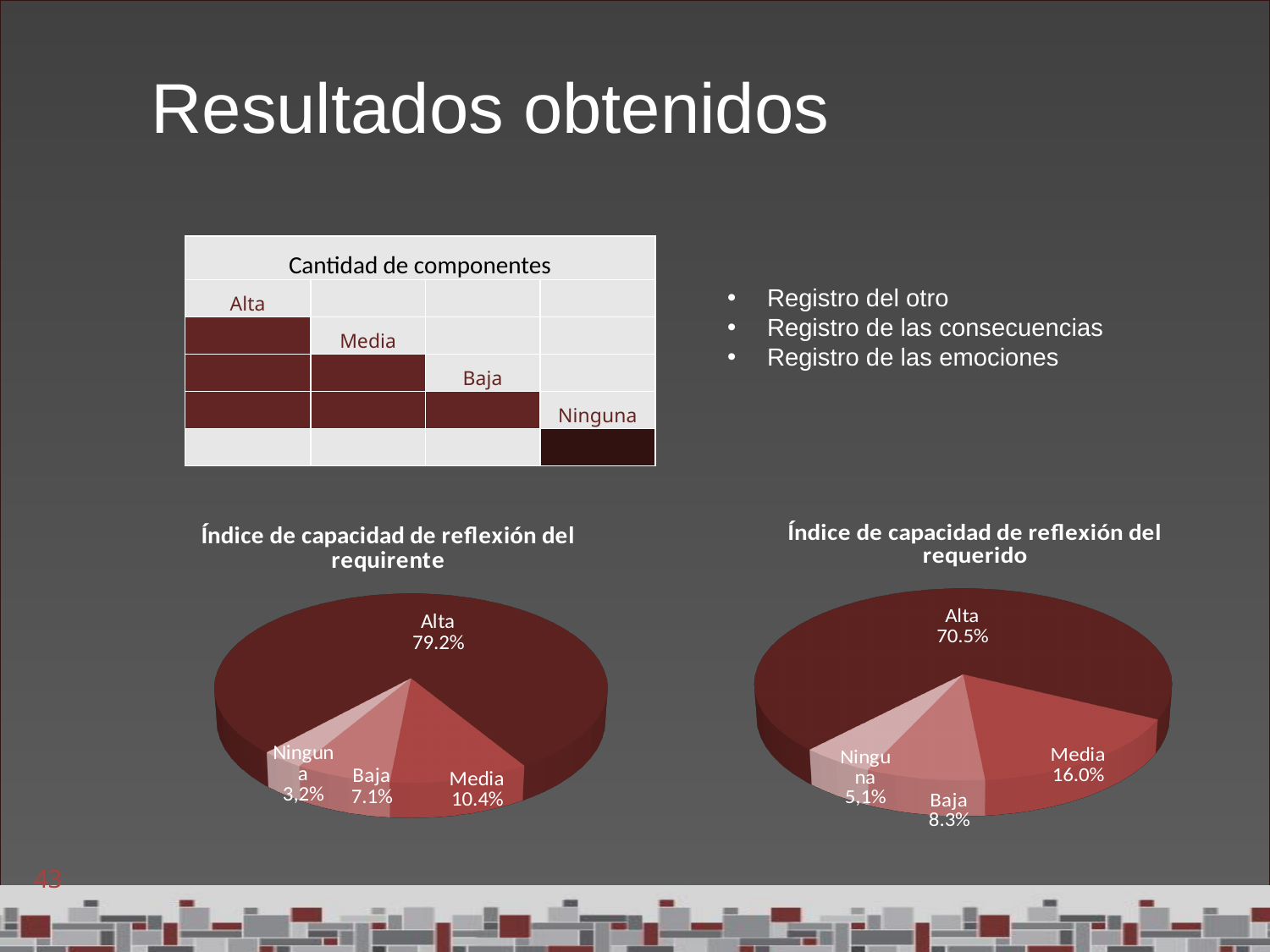
How many categories does the chart titled 'Índice de capacidad de reflexión del requerido' show? 4 In the chart titled 'Índice de capacidad de reflexión del requirente', which is larger, Baja or Media? Media What is the title of the pie chart on the right side of the slide? Índice de capacidad de reflexión del requerido Which chart has the higher value for Alta, 'Índice de capacidad de reflexión del requirente' or 'Índice de capacidad de reflexión del requerido'? Índice de capacidad de reflexión del requirente In the chart titled 'Índice de capacidad de reflexión del requerido', what is the difference between the Alta and Media values? 54.5% In the chart titled 'Índice de capacidad de reflexión del requerido', which category has the smallest share? Ninguna In the chart titled 'Índice de capacidad de reflexión del requerido', what is the value for Ninguna? 5,1% In the chart titled 'Índice de capacidad de reflexión del requerido', what is the value for Baja? 8.3% In the chart titled 'Índice de capacidad de reflexión del requirente', which category has the largest share? Alta What kind of chart is 'Índice de capacidad de reflexión del requirente'? Pie chart In the chart titled 'Índice de capacidad de reflexión del requirente', what is the value for Alta? 79.2% In the chart titled 'Índice de capacidad de reflexión del requirente', what is the value for Media? 10.4%